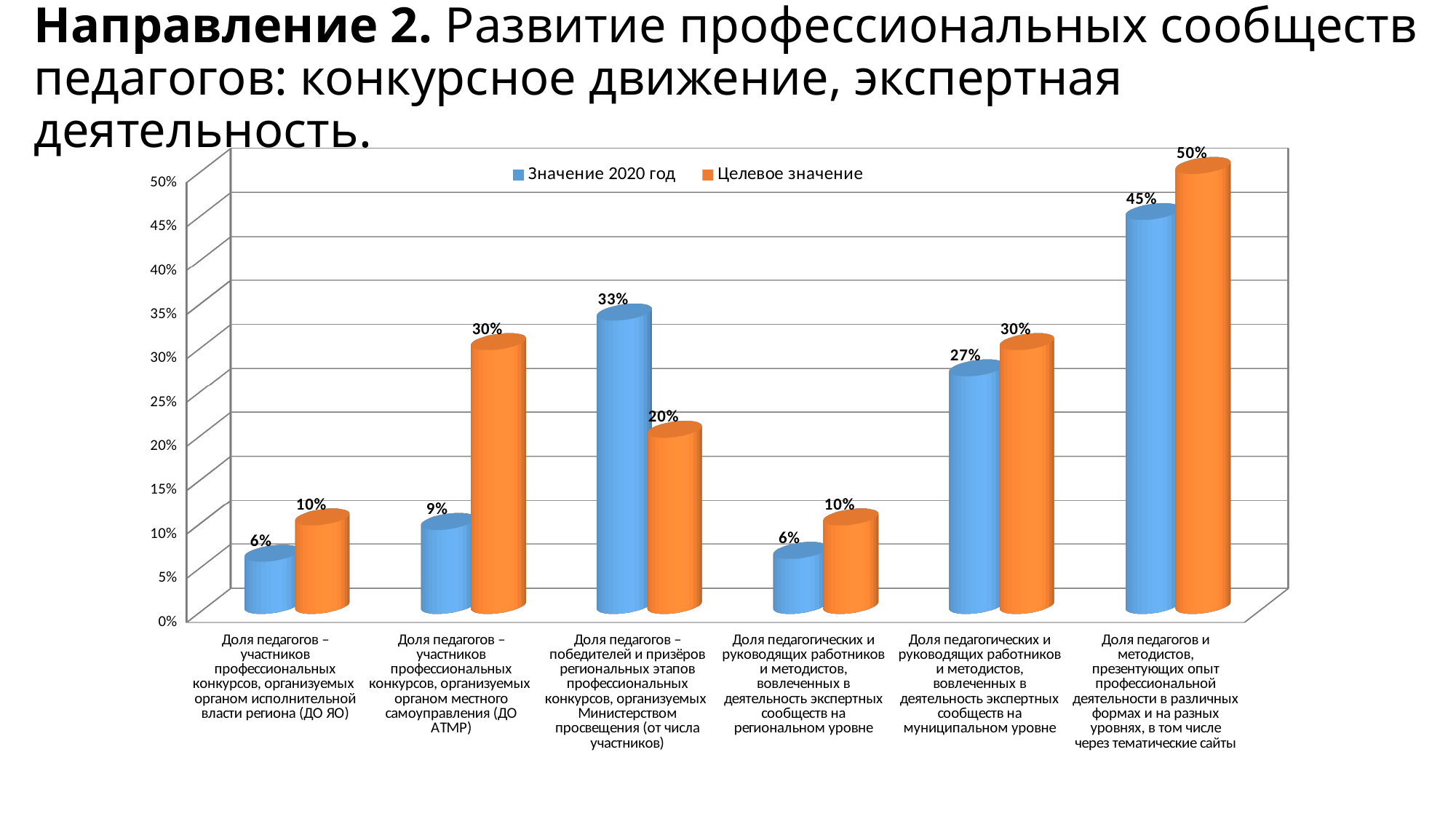
For 'Доля педагогов – победителей и призёров региональных этапов профессиональных конкурсов, организуемых Министерством просвещения (от числа участников)', which is larger: 'Значение 2020 год' or 'Целевое значение'? Значение 2020 год How many categories are shown on the x axis of the chart? 6 Is the 'Значение 2020 год' value for 'Доля педагогов и методистов, презентующих опыт профессиональной деятельности в различных формах и на разных уровнях, в том числе через тематические сайты' greater or less than 40%? greater What is the 'Целевое значение' for 'Доля педагогов – победителей и призёров региональных этапов профессиональных конкурсов, организуемых Министерством просвещения (от числа участников)'? 20% Which colour represents the 'Целевое значение' series in the chart? Orange What kind of chart is shown on the slide? Bar chart How many series does the chart legend list? 2 What is the 'Значение 2020 год' value for 'Доля педагогических и руководящих работников и методистов, вовлеченных в деятельность экспертных сообществ на муниципальном уровне'? 27% What is the difference between the 'Целевое значение' and the 'Значение 2020 год' for 'Доля педагогов – участников профессиональных конкурсов, организуемых органом местного самоуправления (ДО АТМР)'? 21% What is the 'Значение 2020 год' value for 'Доля педагогов – участников профессиональных конкурсов, организуемых органом местного самоуправления (ДО АТМР)'? 9% Which category has the highest 'Целевое значение'? Доля педагогов и методистов, презентующих опыт профессиональной деятельности в различных формах и на разных уровнях, в том числе через тематические сайты